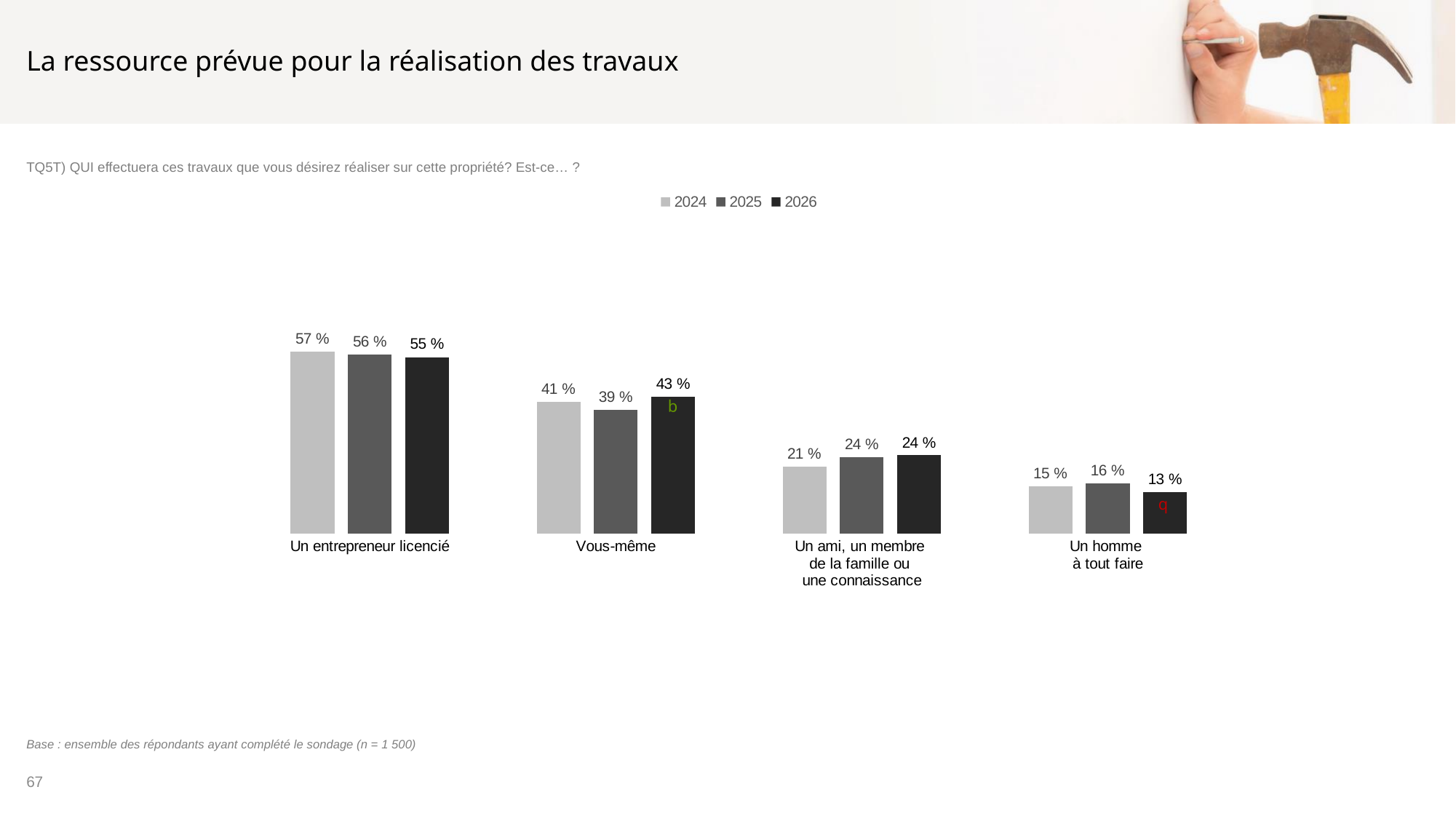
What is the value for 'Un homme à tout faire' in 2025? 16 % How many categories are shown on the x axis? 4 What is the value for 'Un ami, un membre de la famille ou une connaissance' in 2024? 21 % What kind of chart is shown on the slide? Bar chart How many series does the legend list? 3 What is the difference between the 2026 and 2025 values for 'Vous-même'? 4 % What is the value for 'Un entrepreneur licencié' in 2024? 57 % Which is larger for 'Un homme à tout faire': the 2025 value or the 2026 value? 2025 What is the value for 'Vous-même' in 2026? 43 % Which years are listed in the legend? 2024, 2025, 2026 Which category has the highest value in 2026? Un entrepreneur licencié Which category has the lowest value in 2024? Un homme à tout faire